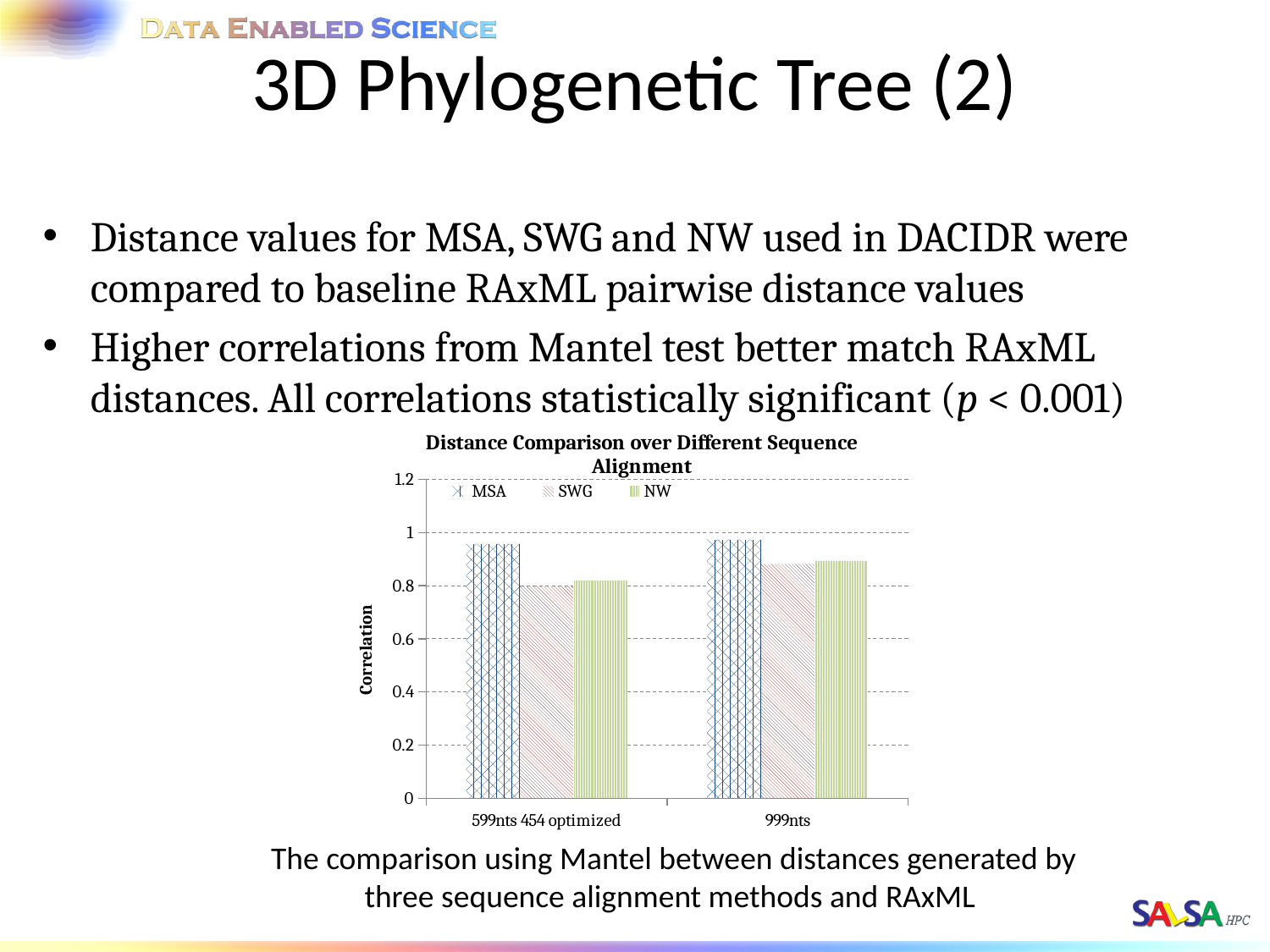
How many categories are shown on the x axis of the chart? 2 For the 999nts category, which is larger, the MSA value or the NW value? MSA Is the MSA value for 599nts 454 optimized greater or less than 0.8? greater What is the title of the chart? Distance Comparison over Different Sequence Alignment How many series does the chart legend list? 3 For the 599nts 454 optimized category, which is larger, the MSA value or the SWG value? MSA Which series has the highest correlation for the 599nts 454 optimized category? MSA Which series has the highest correlation for the 999nts category? MSA What kind of chart is shown on the slide? bar chart Is the NW value for 599nts 454 optimized greater or less than 1? less What is the label on the y axis of the chart? Correlation Is the SWG value for 999nts greater or less than 0.8? greater